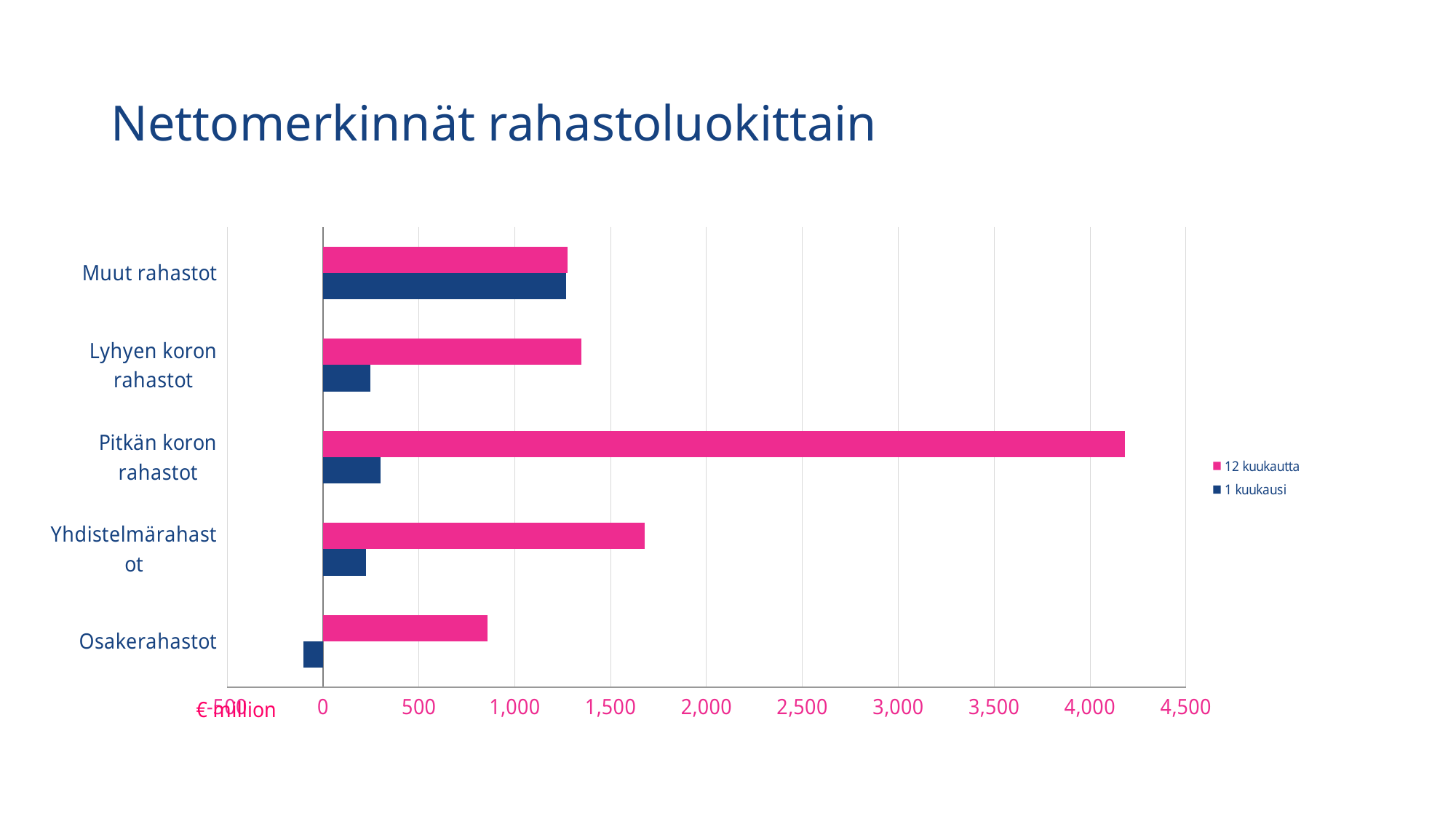
Is the 12 kuukautta value for Pitkän koron rahastot greater or less than 4,000? greater Is the 12 kuukautta value for Yhdistelmärahastot greater or less than 1,500? greater Which category has the highest value for the 1 kuukausi series? Muut rahastot Is the 1 kuukausi value for Osakerahastot greater or less than 0? less Which category has the lowest value for the 12 kuukautta series? Osakerahastot What kind of chart is shown on the slide? Bar chart Which category has the lowest value for the 1 kuukausi series? Osakerahastot Which category has the highest value for the 12 kuukautta series? Pitkän koron rahastot How many series does the legend list? 2 How many fund categories are shown on the chart? 5 Which is larger: the 12 kuukautta value for Lyhyen koron rahastot or for Yhdistelmärahastot? Yhdistelmärahastot What is the title of the chart? Nettomerkinnät rahastoluokittain